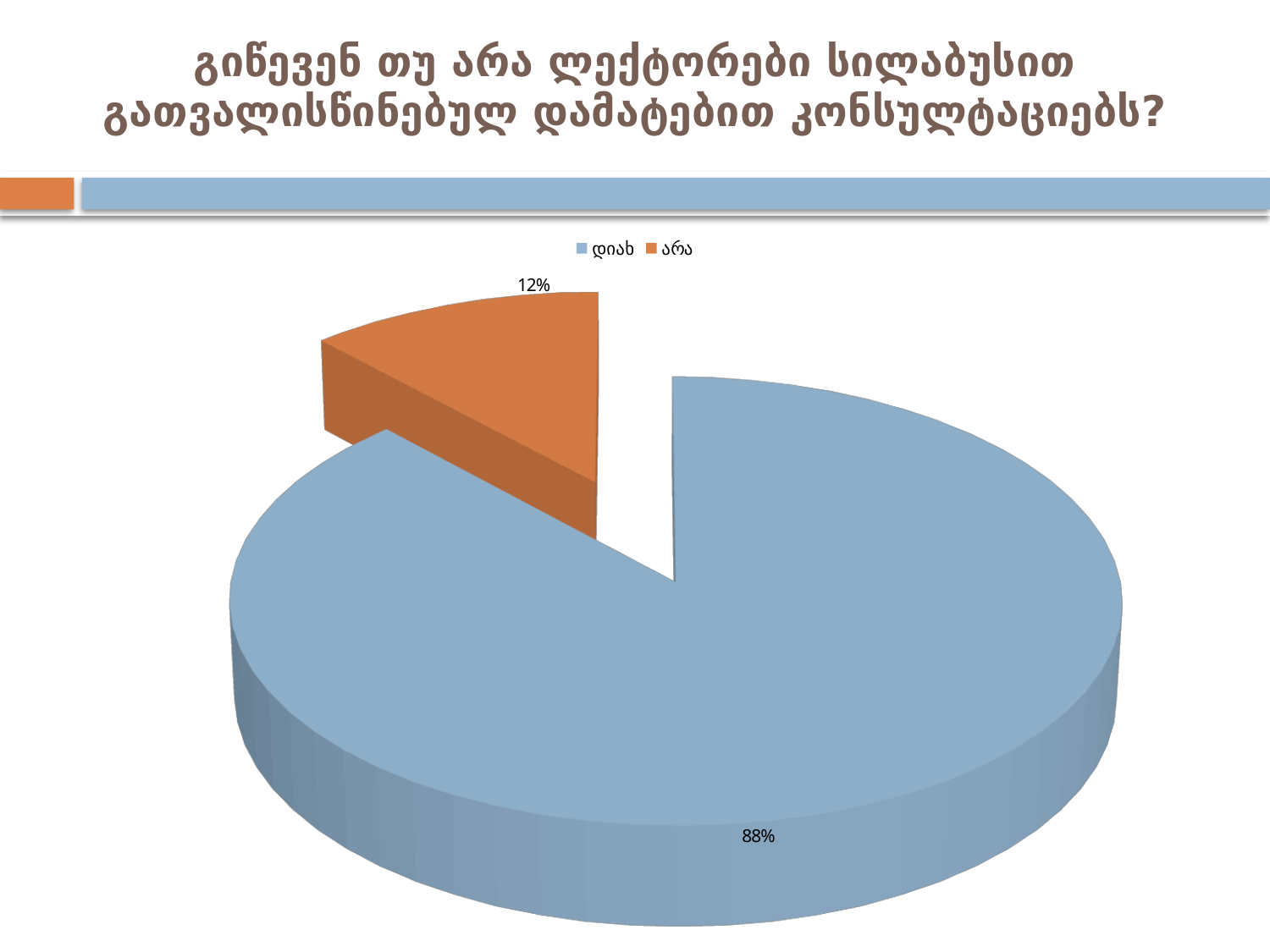
What colour is the slice for დიახ? blue How many slices does the pie chart have? 2 Which is larger, the value for დიახ or the value for არა? დიახ How many entries does the legend list? 2 What is the difference between the values for დიახ and არა? 76% What kind of chart is shown on the slide? pie chart What colour is the slice for არა? orange Which category has the largest share of the pie? დიახ What is the value for არა? 12% What share of the pie does the არა slice represent? 12% What is the value for დიახ? 88% Which category has the smallest share of the pie? არა